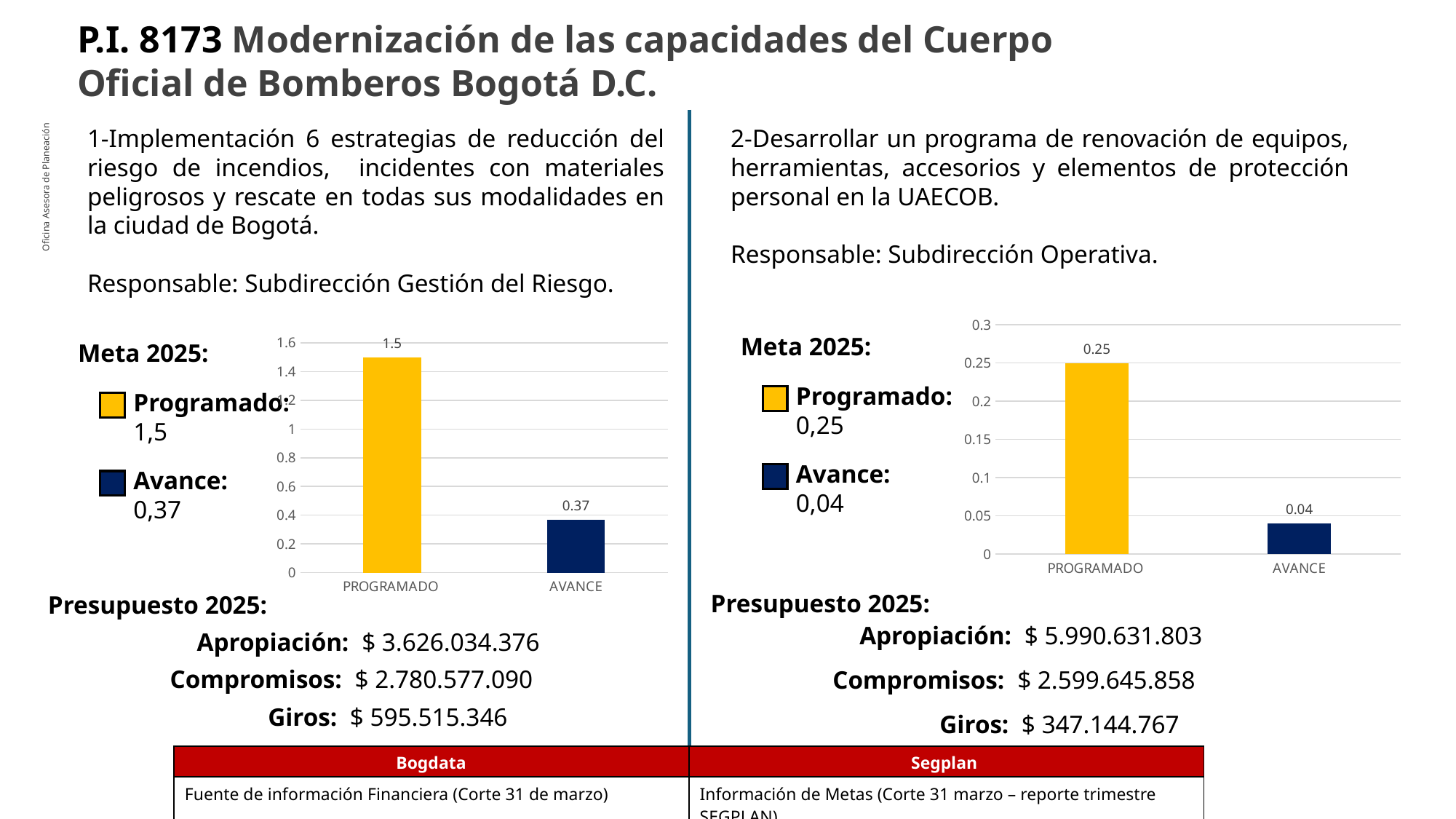
In the left chart, what is the value of the PROGRAMADO bar? 1.5 In the right chart, what is the value of the PROGRAMADO bar? 0.25 In the right chart, which category has the lowest value? AVANCE What type of chart is the right chart? Bar chart In the left chart, which category has the highest value? PROGRAMADO In the left chart, what is the difference between the PROGRAMADO and AVANCE values? 1.13 In the left chart, what colour is the AVANCE bar? Dark blue In the right chart, which is larger, PROGRAMADO or AVANCE? PROGRAMADO How many bars are shown in the left chart? 2 In the right chart, what is the value of the AVANCE bar? 0.04 In the right chart, what is the difference between the PROGRAMADO and AVANCE values? 0.21 In the left chart, what is the value of the AVANCE bar? 0.37